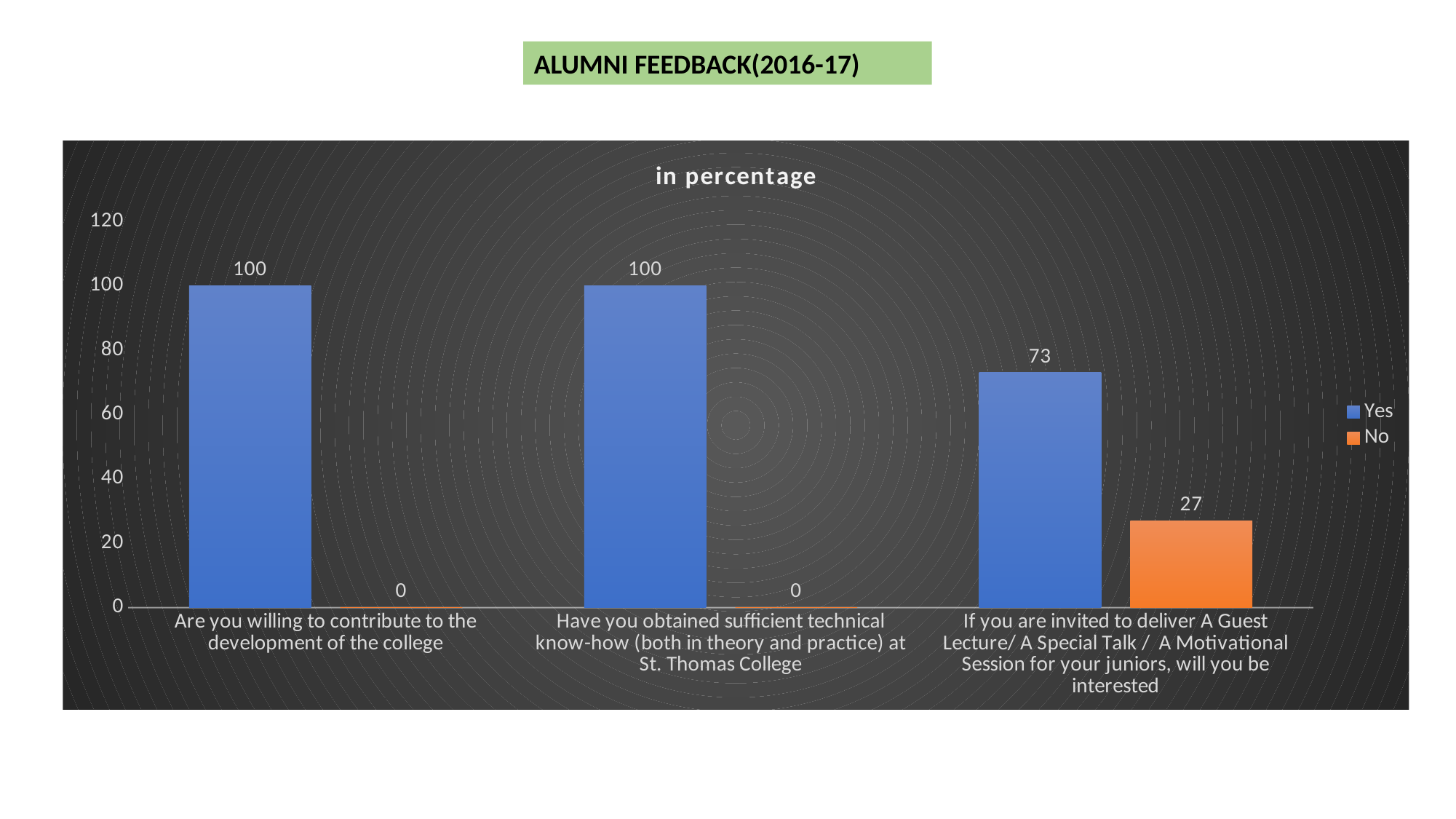
Which question has the lowest 'Yes' value? If you are invited to deliver A Guest Lecture/ A Special Talk / A Motivational Session for your juniors, will you be interested What kind of chart is shown on the slide? Bar chart How many series does the legend list? 2 What is the 'Yes' value for 'Are you willing to contribute to the development of the college'? 100 How many questions (categories) are shown on the x axis? 3 What is the 'Yes' value for 'If you are invited to deliver A Guest Lecture/ A Special Talk / A Motivational Session for your juniors, will you be interested'? 73 What is the 'No' value for 'If you are invited to deliver A Guest Lecture/ A Special Talk / A Motivational Session for your juniors, will you be interested'? 27 What is the difference between the 'Yes' and 'No' values for the guest lecture question? 46 What is the title of the chart? in percentage Which question has the highest 'No' value? If you are invited to deliver A Guest Lecture/ A Special Talk / A Motivational Session for your juniors, will you be interested What is the 'No' value for 'Have you obtained sufficient technical know-how (both in theory and practice) at St. Thomas College'? 0 For the guest lecture question, which is larger, the 'Yes' value or the 'No' value? Yes